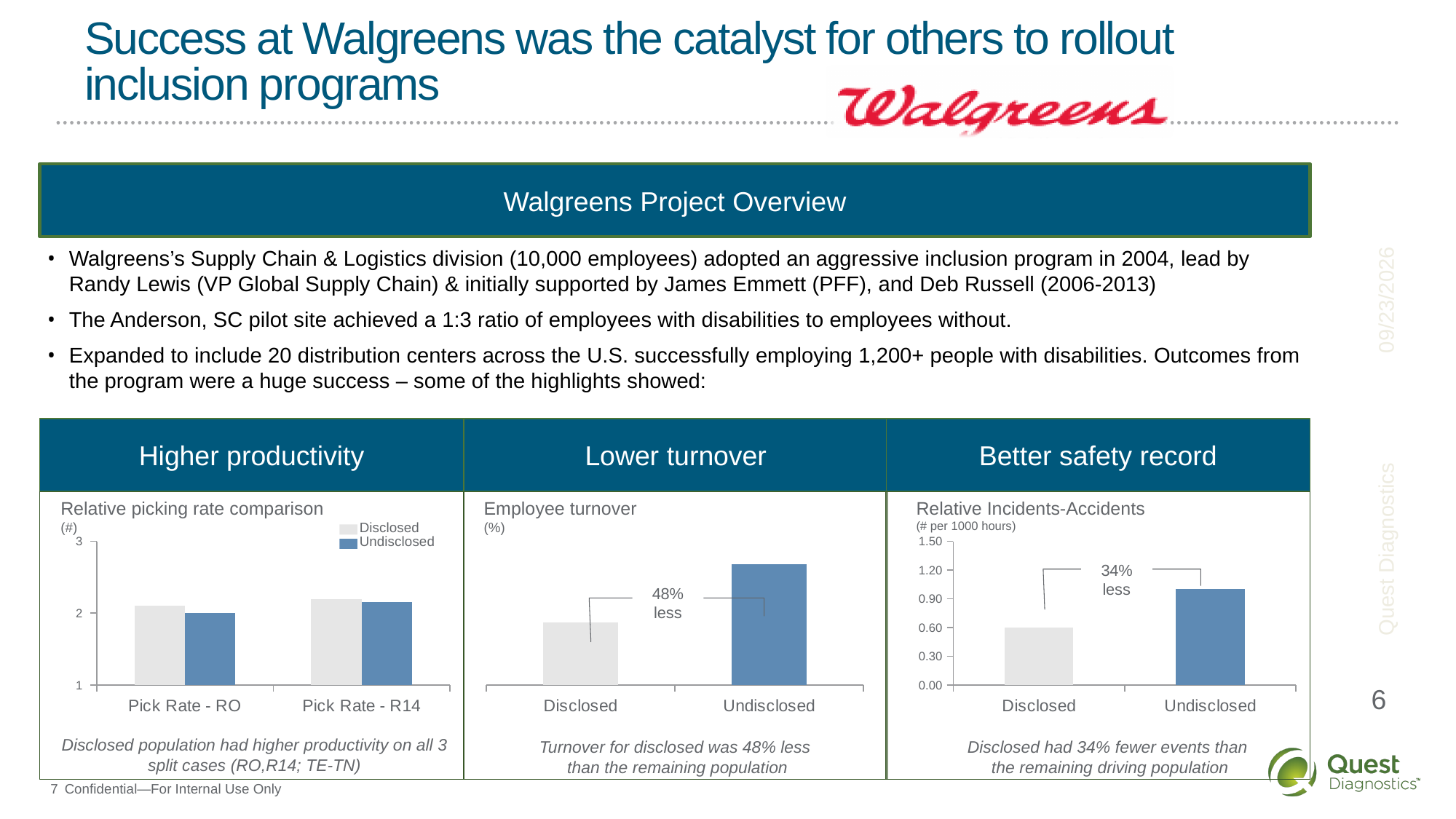
In the 'Relative Incidents-Accidents' chart, is the value for Undisclosed greater or less than 0.90? greater In the 'Relative picking rate comparison' chart, how many series does the legend list? 2 In the 'Relative picking rate comparison' chart, what kind of chart is used? bar chart In the 'Employee turnover' chart, what kind of chart is used? bar chart In the 'Employee turnover' chart, what percentage difference is annotated between the two bars? 48% less In the 'Relative Incidents-Accidents' chart, what unit is given for the y axis? # per 1000 hours In the 'Relative Incidents-Accidents' chart, which category has the lowest value? Disclosed In the 'Relative picking rate comparison' chart, is the Disclosed value for Pick Rate - R14 greater or less than 3? less In the 'Relative picking rate comparison' chart, for Pick Rate - RO, which is larger: Disclosed or Undisclosed? Disclosed In the 'Employee turnover' chart, which category has the highest value? Undisclosed In the 'Relative picking rate comparison' chart, how many categories are shown on the x axis? 2 In the 'Relative Incidents-Accidents' chart, is the value for Disclosed greater or less than 0.90? less